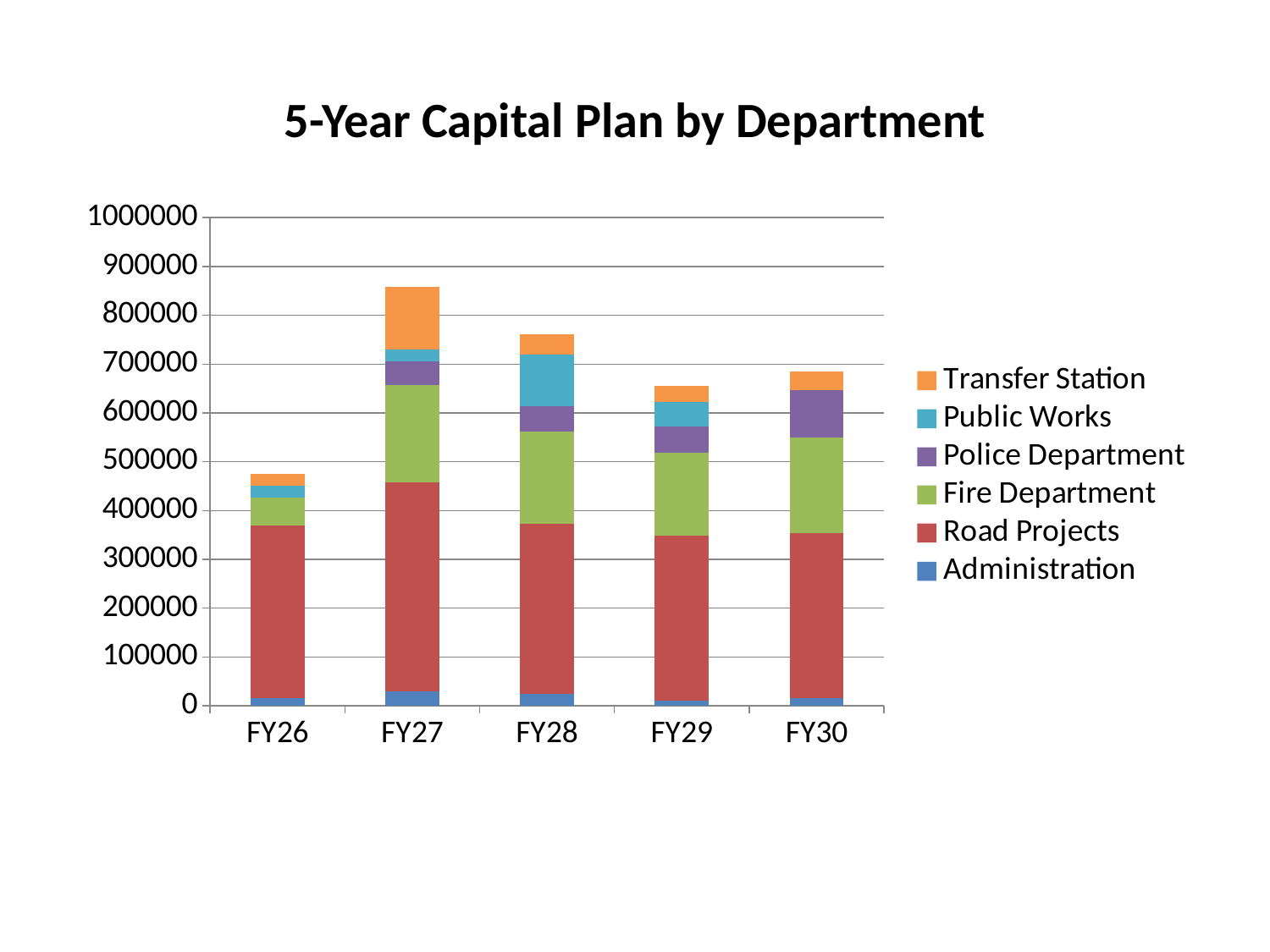
Which department is shown in orange in the legend? Transfer Station Which fiscal year has the highest total capital plan? FY27 Which fiscal year has the lowest total capital plan? FY26 Which fiscal year has the larger total, FY28 or FY29? FY28 How many departments does the legend list? 6 Is the total for FY26 greater or less than 500000? less What kind of chart is shown on the slide? stacked bar chart Does the total capital plan rise or fall from FY26 to FY27? rise How many fiscal years are shown on the x axis? 5 Is the total for FY27 greater or less than 800000? greater Is the total for FY28 greater or less than 700000? greater What is the title of the chart? 5-Year Capital Plan by Department